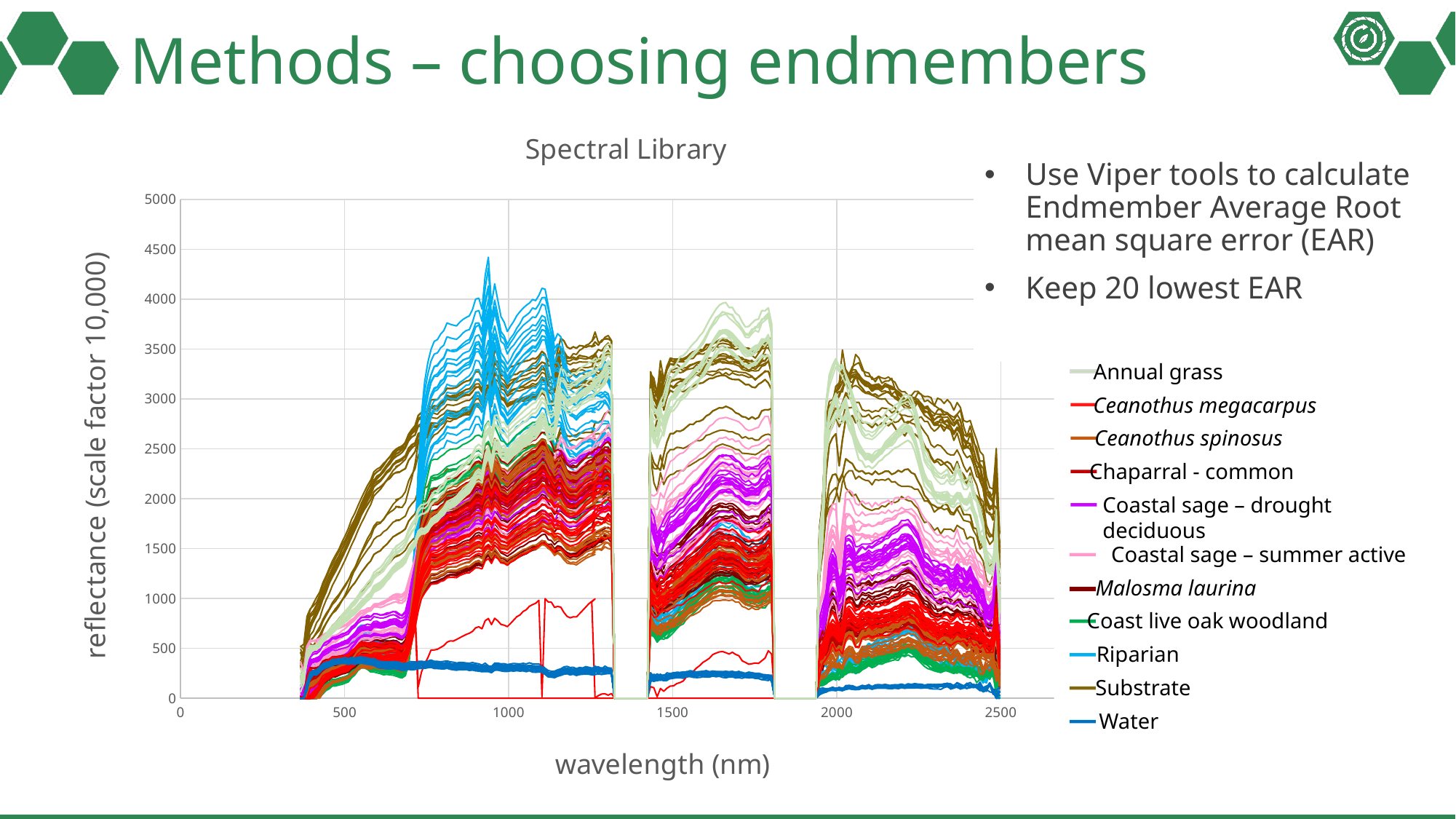
What is the label of the x axis? wavelength (nm) Is the highest Substrate reflectance near 2000 nm greater or less than 3000? greater Which series reaches the highest reflectance value on the chart? Riparian What is the maximum value shown on the y axis? 5000 How many series does the chart's legend list? 11 Is the peak reflectance of the Riparian series greater or less than 4000? greater What kind of chart is shown on the slide? line chart Which series has the lowest reflectance values across the wavelength range? Water Does the Water series rise or fall between 1000 nm and 2500 nm? fall Which series has higher reflectance around 1000 nm, Riparian or Water? Riparian Is the reflectance of the Water series at 1000 nm greater or less than 500? less What is the title of the chart? Spectral Library